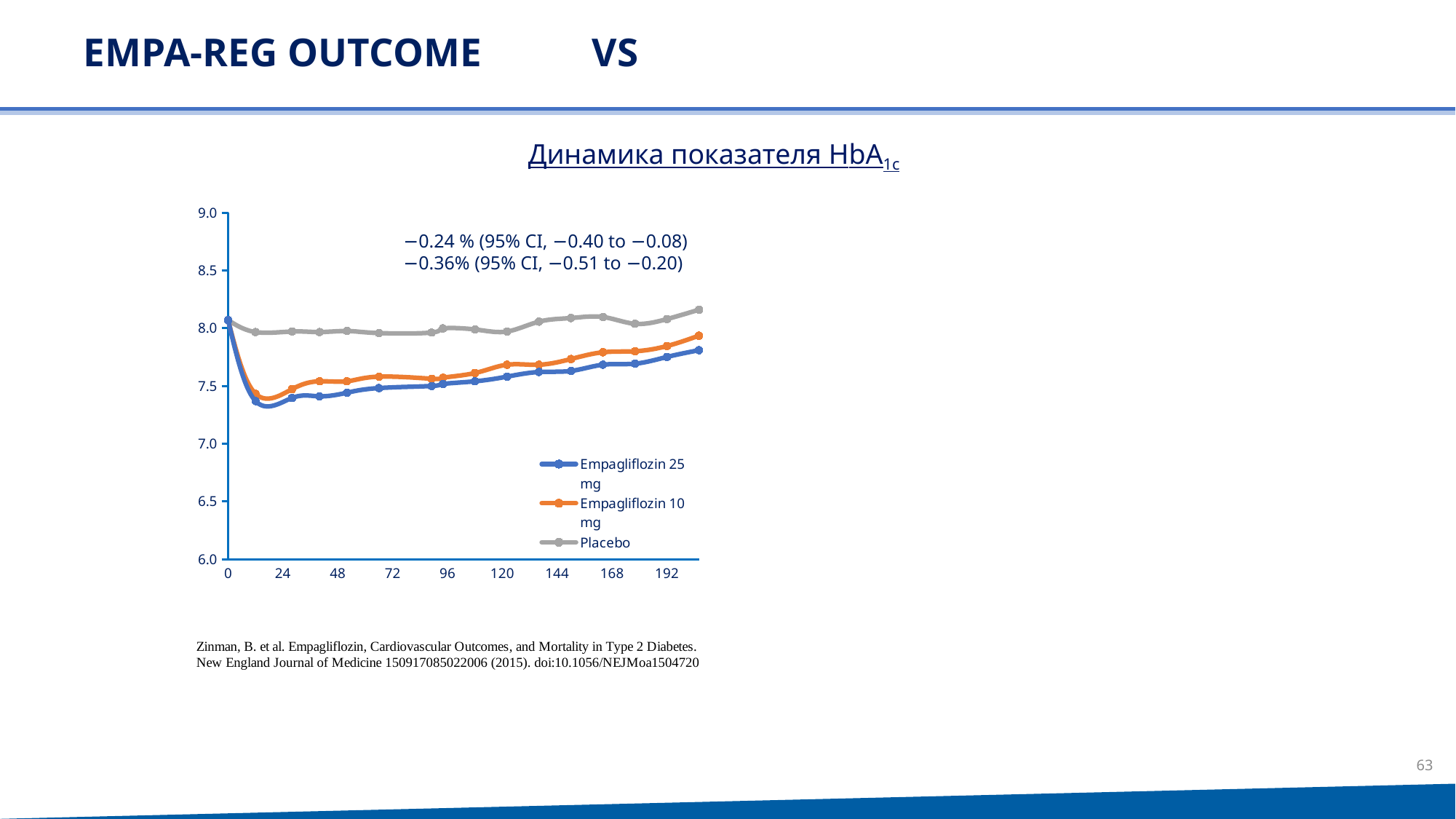
Is the value for Empagliflozin 25 mg at week 24 greater or less than 8.0? less What kind of chart is shown on the slide? line chart What is the title of the chart? Динамика показателя HbA1c Is the value for Placebo at week 96 greater or less than 7.5? greater How many series does the legend list? 3 At week 96, which is higher: Placebo or Empagliflozin 25 mg? Placebo Which series has the lowest value at week 192? Empagliflozin 25 mg Which series has the highest value at week 192? Placebo Does the Placebo line rise or fall from week 24 to the end of the x axis? rise Which colour is used for the Placebo line? grey At week 144, which is higher: Empagliflozin 10 mg or Empagliflozin 25 mg? Empagliflozin 10 mg Does the Empagliflozin 25 mg line rise or fall between week 0 and week 24? fall